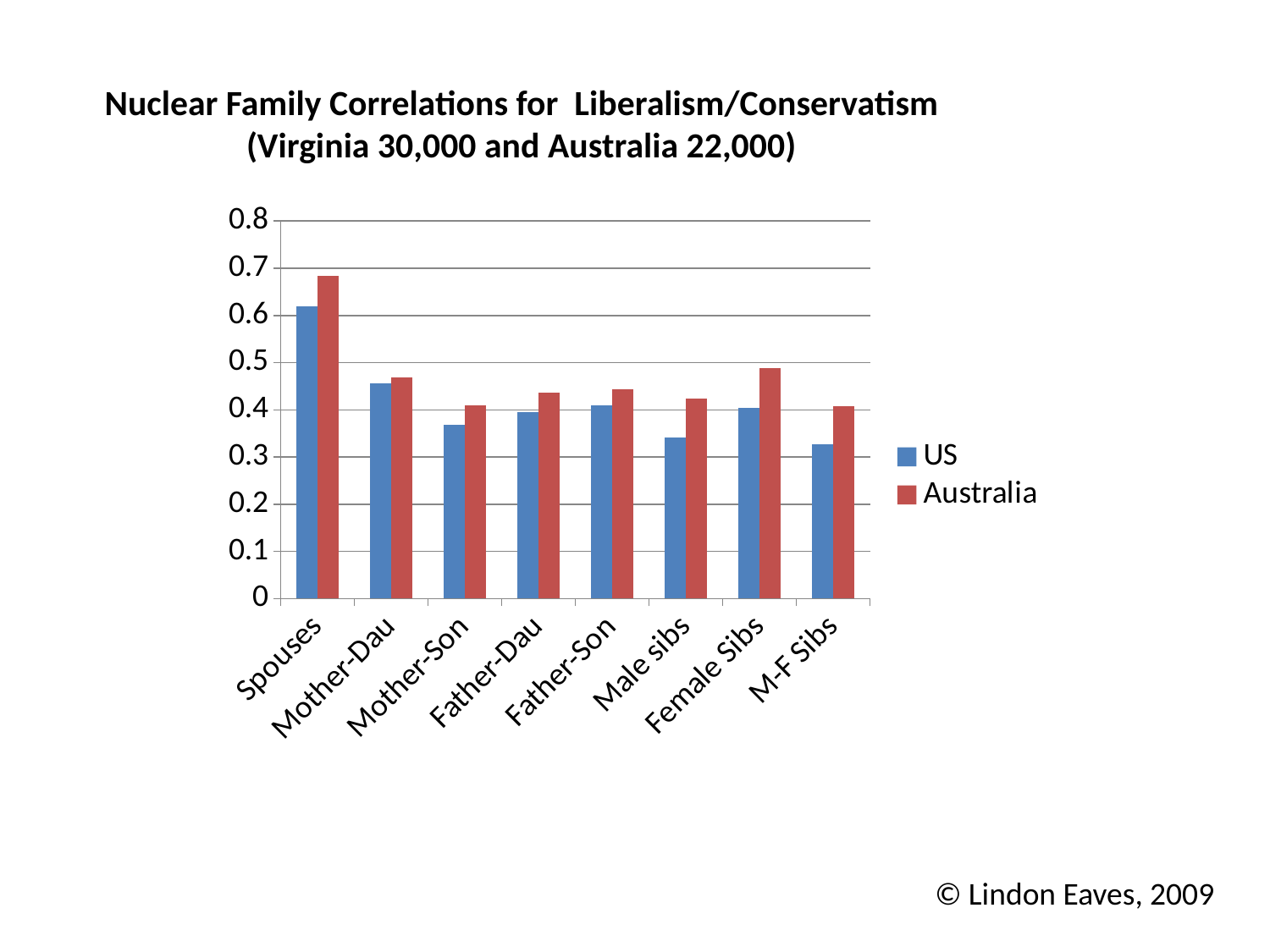
Is the Australia value for Spouses greater or less than 0.6? greater What are the two series named in the legend? US and Australia Is the US value for M-F Sibs greater or less than 0.4? less For Male sibs, which series has the larger value, US or Australia? Australia For Spouses, which series has the larger value, US or Australia? Australia Is the US value for Male sibs greater or less than 0.4? less How many series does the legend list? 2 What kind of chart is shown on the slide? bar chart How many categories are shown on the x axis of the chart? 8 Which category has the highest Australia correlation? Spouses Which category has the highest US correlation? Spouses